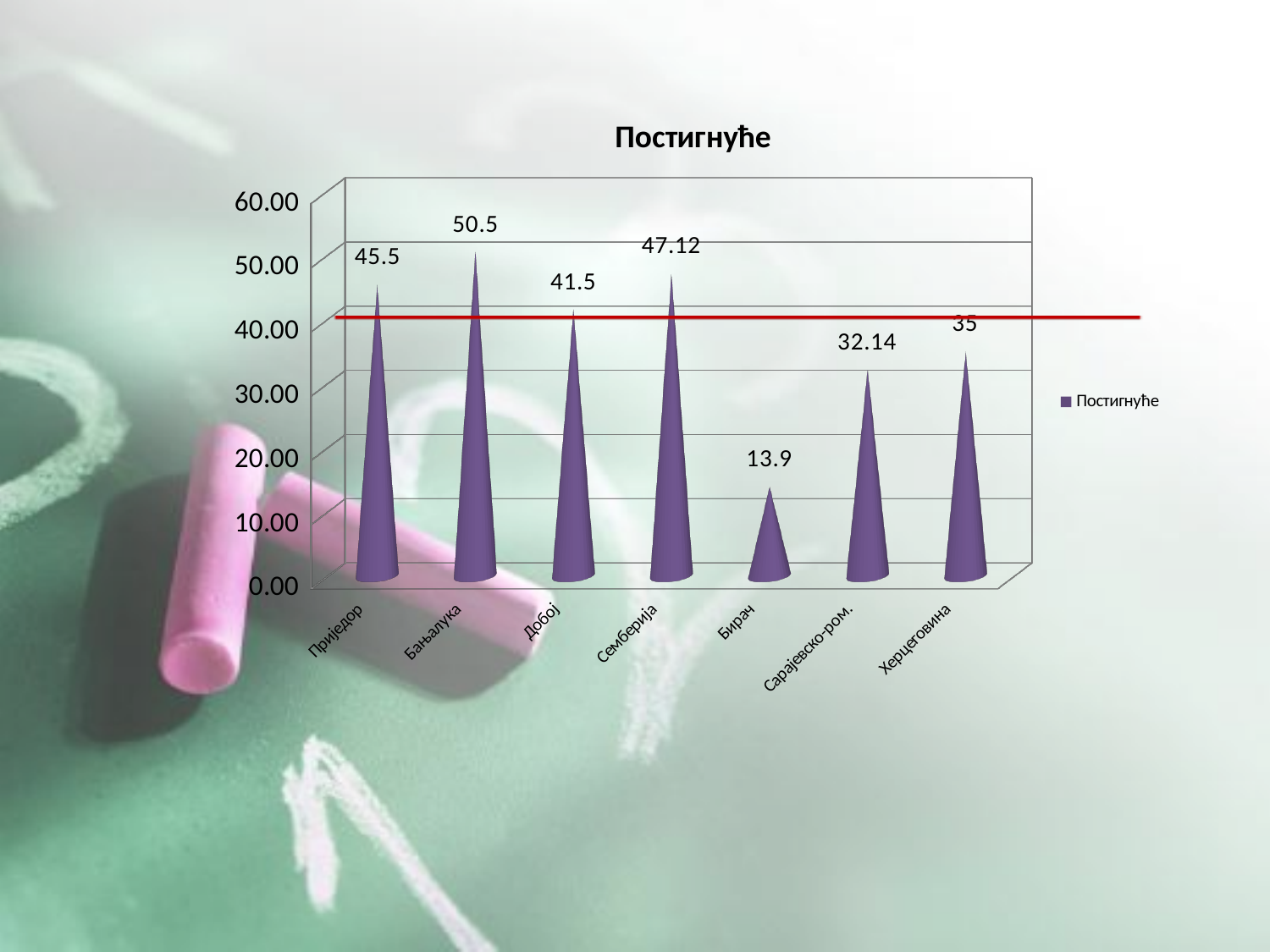
Is the value for Херцеговина greater or less than 40.00? less What is the value for Бирач? 13.9 What is the difference between the values for Бањалука and Приједор? 5 Which category has the highest value? Бањалука What is the value for Бањалука? 50.5 Which category has the lowest value? Бирач What is the title of the chart? Постигнуће What kind of chart is shown? bar chart How many categories are shown on the x axis? 7 Which is larger, the value for Семберија or the value for Добој? Семберија How many series does the legend list? 1 What is the value for Сарајевско-ром.? 32.14